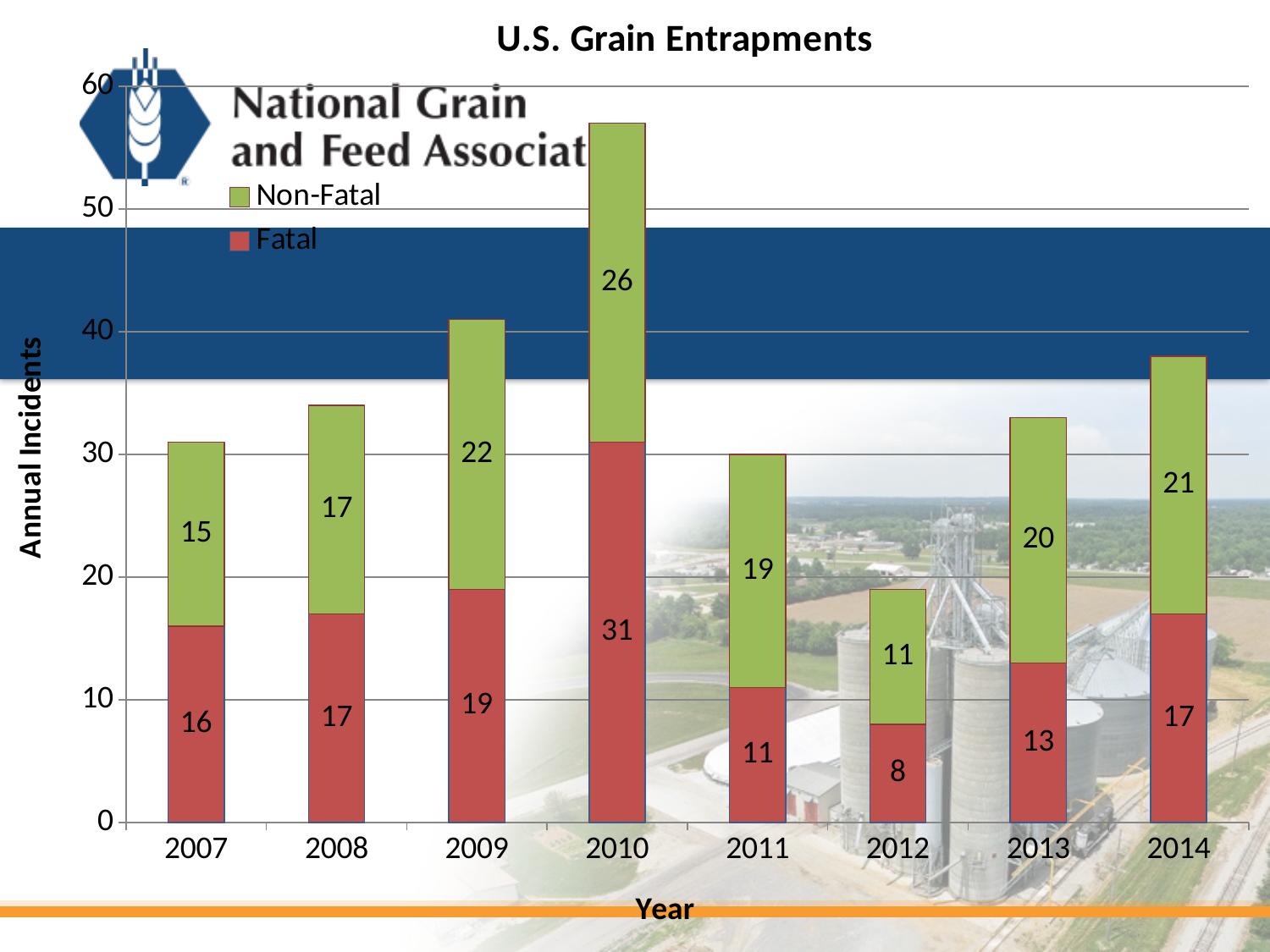
Which is larger, the Non-Fatal value for 2013 or the Non-Fatal value for 2011? 2013 What is the total of the stacked bar for 2014? 38 Which year has the highest Fatal value? 2010 What kind of chart is this? Stacked bar chart How many years are shown on the x axis? 8 What is the Fatal value for 2010? 31 What is the title of the chart? U.S. Grain Entrapments What is the total of the stacked bar for 2009? 41 How many series does the legend list? 2 What is the Non-Fatal value for 2012? 11 Which year has the lowest Fatal value? 2012 What is the difference between the Non-Fatal values for 2010 and 2007? 11